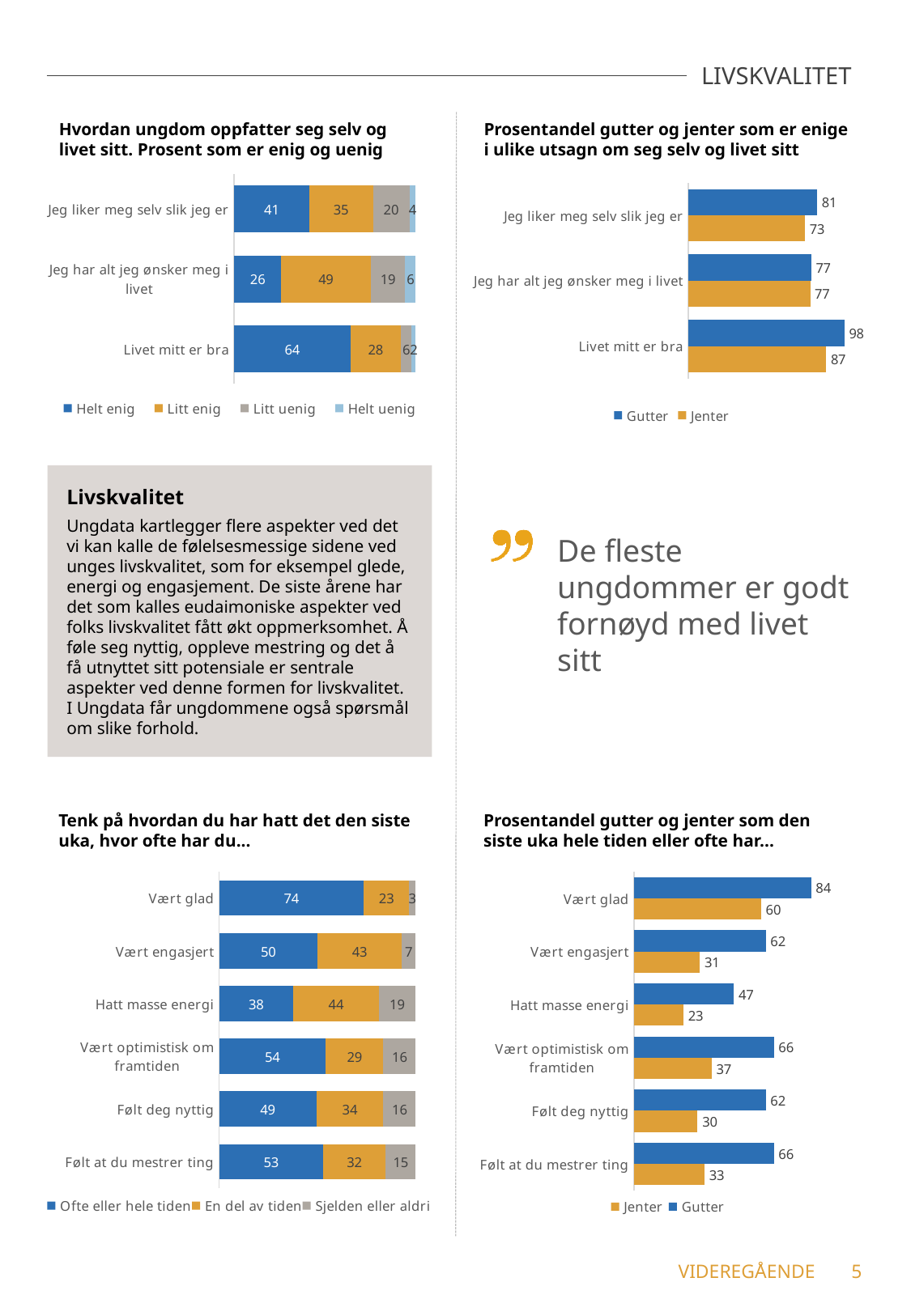
In the top-right chart 'Prosentandel gutter og jenter som er enige i ulike utsagn om seg selv og livet sitt', which statement has the lowest value for Jenter? Jeg liker meg selv slik jeg er In the bottom-left chart 'Tenk på hvordan du har hatt det den siste uka, hvor ofte har du…', what is the 'Sjelden eller aldri' value for 'Hatt masse energi'? 19 In the bottom-left chart 'Tenk på hvordan du har hatt det den siste uka, hvor ofte har du…', how many categories are shown? 6 In the bottom-left chart 'Tenk på hvordan du har hatt det den siste uka, hvor ofte har du…', which category has the highest 'Ofte eller hele tiden' value? Vært glad In the top-left chart 'Hvordan ungdom oppfatter seg selv og livet sitt', what is the 'Litt enig' value for 'Jeg har alt jeg ønsker meg i livet'? 49 In the top-right chart 'Prosentandel gutter og jenter som er enige i ulike utsagn om seg selv og livet sitt', what is the difference between Gutter and Jenter for 'Jeg liker meg selv slik jeg er'? 8 In the bottom-right chart 'Prosentandel gutter og jenter som den siste uka hele tiden eller ofte har…', which is larger for 'Følt deg nyttig': Gutter or Jenter? Gutter In the top-left chart 'Hvordan ungdom oppfatter seg selv og livet sitt', what is the 'Helt enig' value for 'Livet mitt er bra'? 64 In the top-right chart 'Prosentandel gutter og jenter som er enige i ulike utsagn om seg selv og livet sitt', what is the value for Gutter on 'Livet mitt er bra'? 98 In the top-left chart 'Hvordan ungdom oppfatter seg selv og livet sitt', how many series does the legend list? 4 In the bottom-right chart 'Prosentandel gutter og jenter som den siste uka hele tiden eller ofte har…', what is the value for Jenter on 'Vært glad'? 60 What kind of chart is the bottom-right chart 'Prosentandel gutter og jenter som den siste uka hele tiden eller ofte har…'? Bar chart